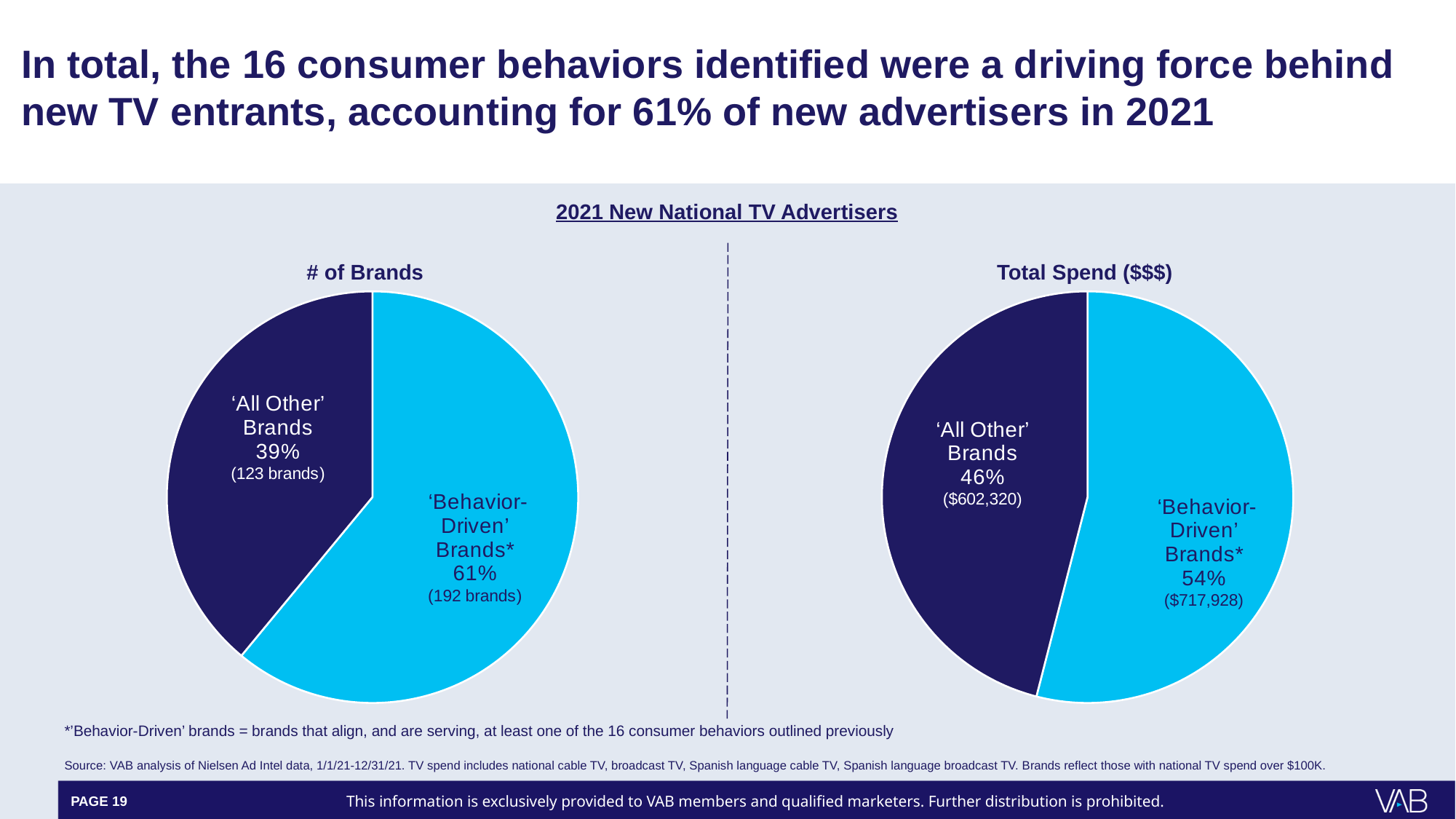
What is the overall title above the two pie charts? 2021 New National TV Advertisers In the '# of Brands' pie chart, how many brands are 'Behavior-Driven' Brands? 192 brands In the 'Total Spend ($$$)' pie chart, what is the spend for 'Behavior-Driven' Brands? $717,928 In the '# of Brands' pie chart, what is the difference in number of brands between 'Behavior-Driven' Brands and 'All Other' Brands? 69 brands In the 'Total Spend ($$$)' pie chart, what share of spend is 'All Other' Brands? 46% In the '# of Brands' pie chart, how many brands are 'All Other' Brands? 123 brands In the 'Total Spend ($$$)' pie chart, what is the spend for 'All Other' Brands? $602,320 In the 'Total Spend ($$$)' pie chart, which slice is smaller? 'All Other' Brands In the '# of Brands' pie chart, what share of brands is 'Behavior-Driven' Brands? 61% What type of chart is used for '# of Brands'? Pie chart In the '# of Brands' pie chart, which slice is larger? 'Behavior-Driven' Brands How many slices does the 'Total Spend ($$$)' pie chart have? 2